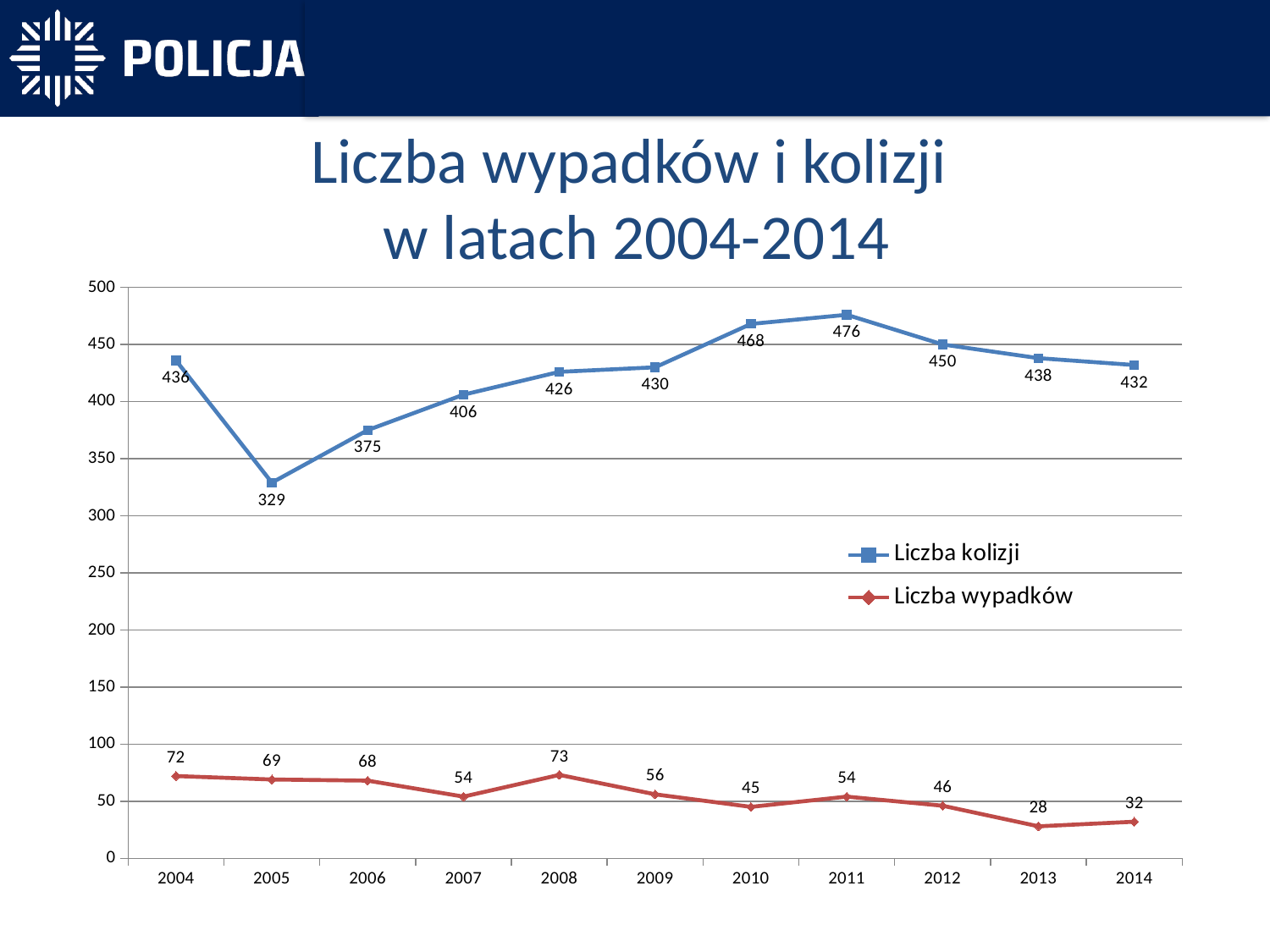
Is the value of Liczba kolizji in 2010 greater or less than 450? greater What is the difference between Liczba kolizji in 2011 and in 2005? 147 In which year is Liczba kolizji highest? 2011 What kind of chart is shown on the slide? line chart What is the value of Liczba kolizji in 2005? 329 What is the value of Liczba wypadków in 2013? 28 In which year is Liczba wypadków lowest? 2013 What is the value of Liczba kolizji in 2011? 476 What is the difference between Liczba wypadków in 2004 and in 2014? 40 How many series does the legend list? 2 Which is larger: Liczba wypadków in 2008 or in 2009? 2008 How many years are shown on the x axis? 11